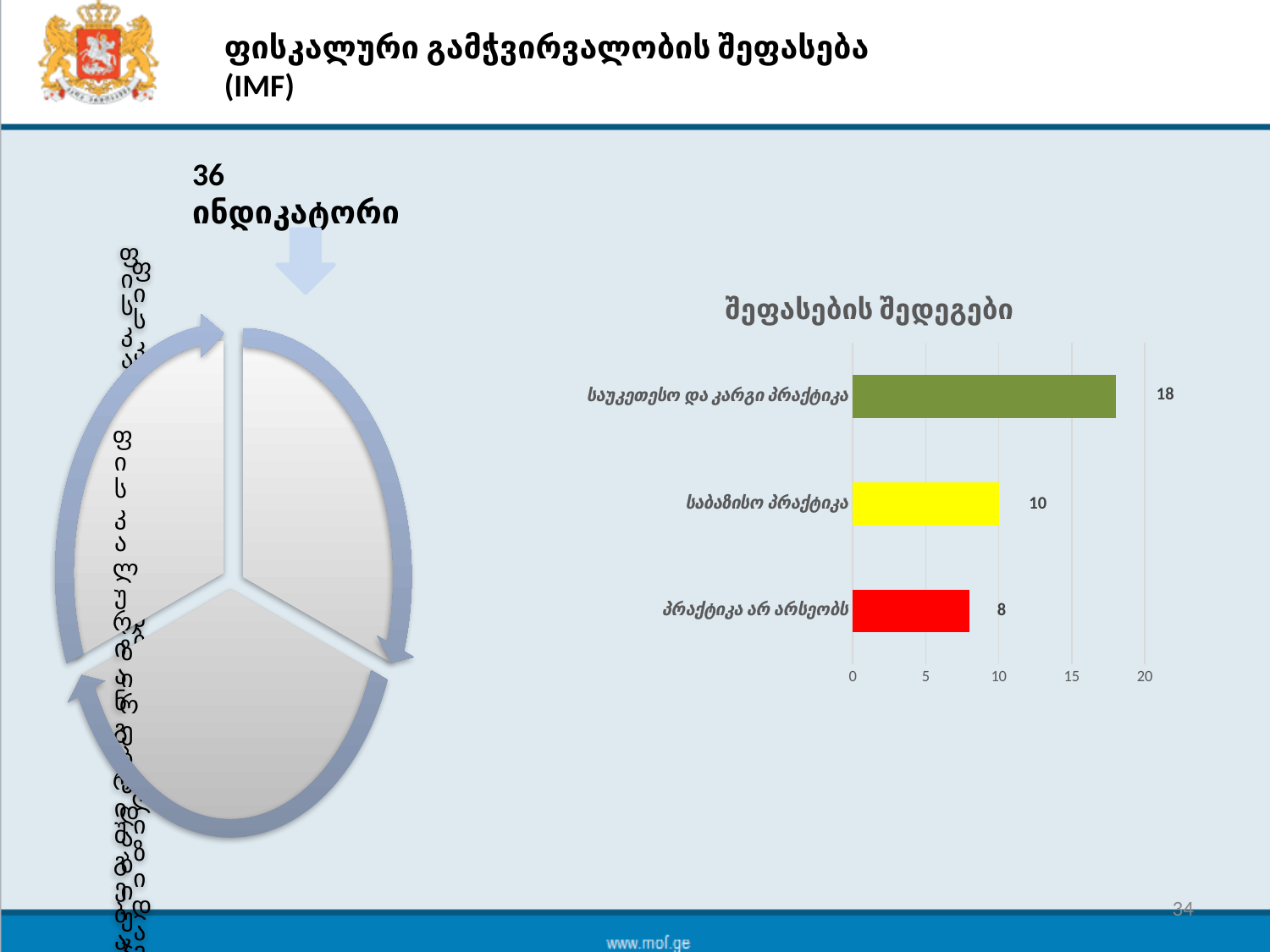
What kind of chart is shown on the slide? bar chart What is the title of the chart? შეფასების შედეგები What is the value for საბაზისო პრაქტიკა? 10 Is the value for საუკეთესო და კარგი პრაქტიკა greater or less than 15? greater How many categories are shown in the chart? 3 Which is larger, the value for საბაზისო პრაქტიკა or the value for პრაქტიკა არ არსებობს? საბაზისო პრაქტიკა What is the value for პრაქტიკა არ არსებობს? 8 What is the difference between the values for საუკეთესო და კარგი პრაქტიკა and საბაზისო პრაქტიკა? 8 What is the value for საუკეთესო და კარგი პრაქტიკა? 18 Which category has the lowest value? პრაქტიკა არ არსებობს Which category has the highest value? საუკეთესო და კარგი პრაქტიკა What is the difference between the values for საბაზისო პრაქტიკა and პრაქტიკა არ არსებობს? 2